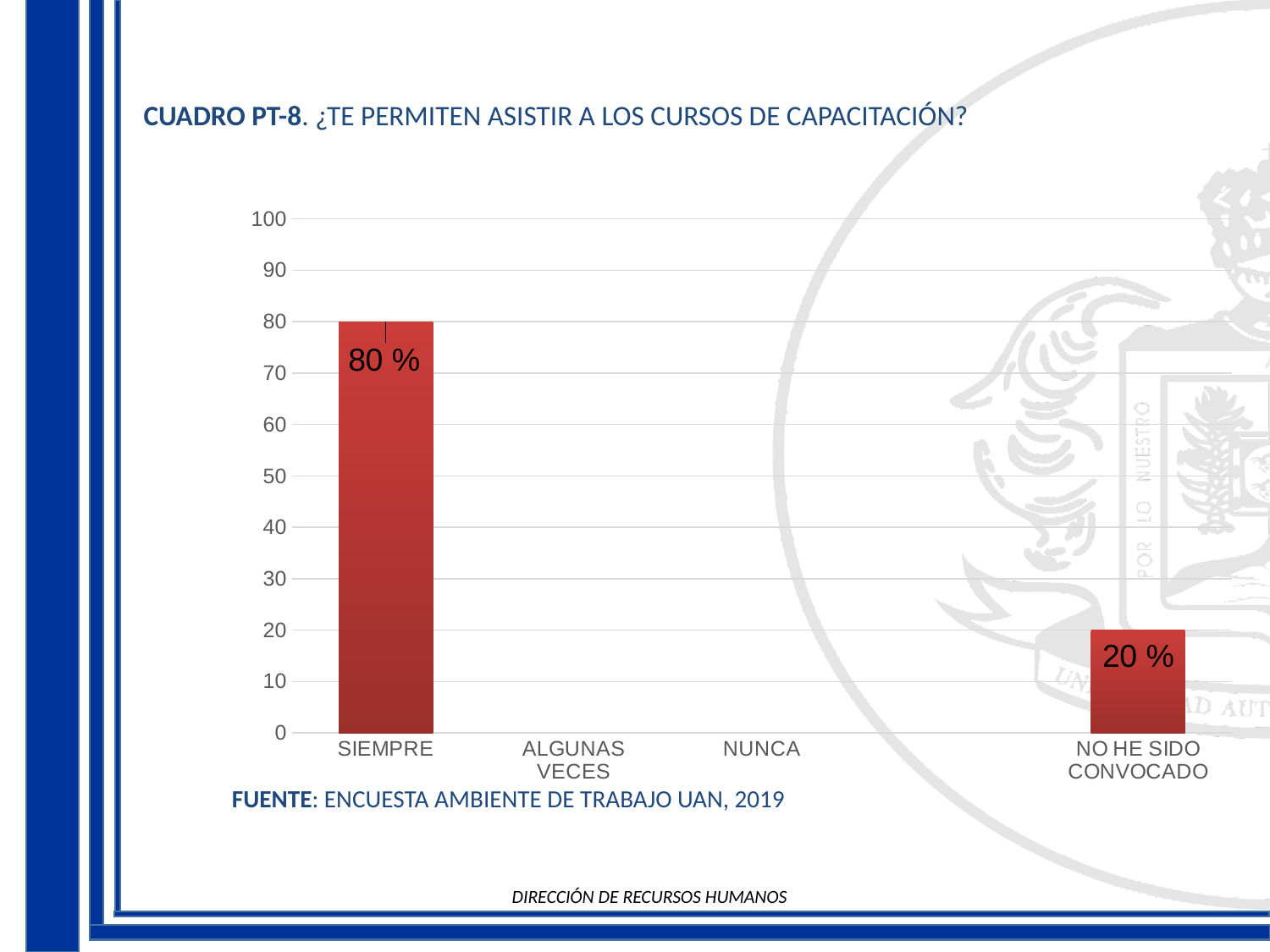
What is the title of the chart? CUADRO PT-8. ¿TE PERMITEN ASISTIR A LOS CURSOS DE CAPACITACIÓN? How many categories are shown on the x axis? 4 Which category has the highest value? SIEMPRE Is the value for SIEMPRE greater or less than 50? greater Is the value for NO HE SIDO CONVOCADO greater or less than 30? less Which is larger, the value for SIEMPRE or the value for NO HE SIDO CONVOCADO? SIEMPRE What is the maximum value shown on the vertical axis? 100 What kind of chart is shown on the slide? Bar chart What is the value for NO HE SIDO CONVOCADO? 20 % What is the value for SIEMPRE? 80 % What is the difference between the values for SIEMPRE and NO HE SIDO CONVOCADO? 60 % Which categories show no visible bar? ALGUNAS VECES and NUNCA